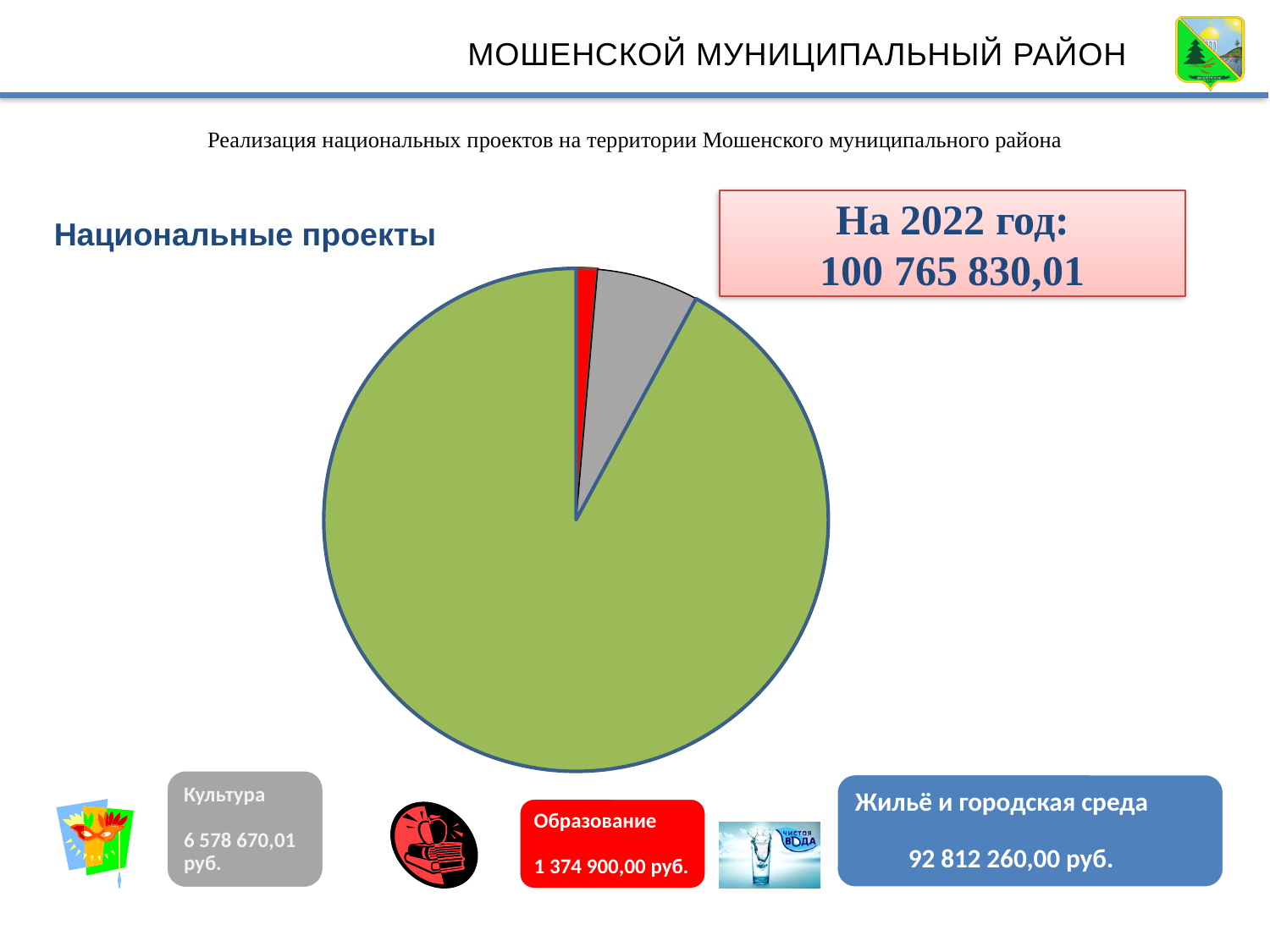
How many slices does the pie chart have? 3 What is the value for Жильё и городская среда? 92 812 260,00 руб. What is the title of the pie chart? Национальные проекты What is the total amount for all national projects in 2022? 100 765 830,01 What is the difference between the values for Культура and Образование? 5 203 770,01 руб. What kind of chart is shown on the slide? pie chart What colour is the largest slice of the pie chart? green What is the value for Образование? 1 374 900,00 руб. Which national project has the smallest slice of the pie? Образование What is the value for Культура? 6 578 670,01 руб. Which is larger, the value for Культура or the value for Образование? Культура Which national project has the largest slice of the pie? Жильё и городская среда